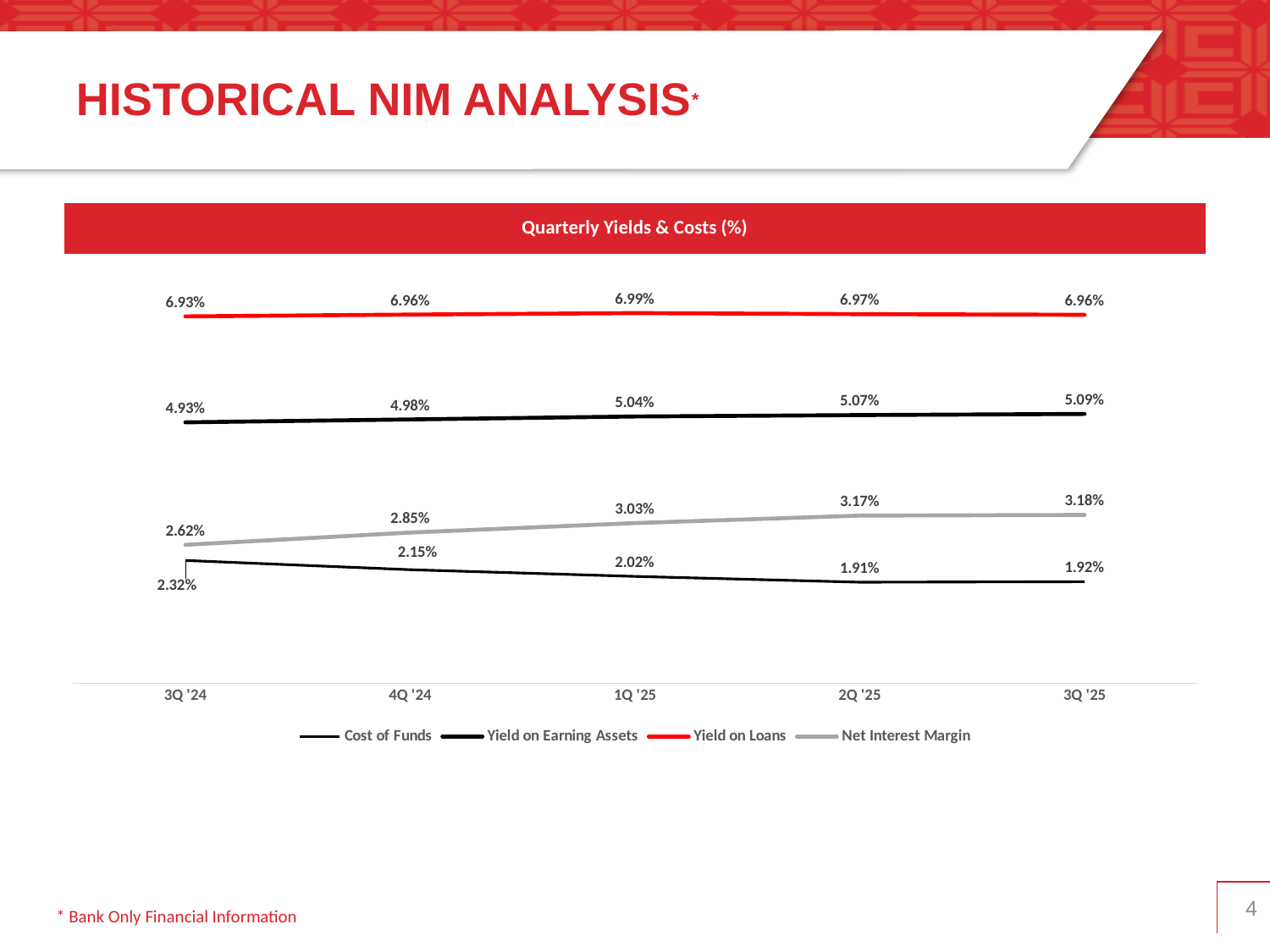
In which quarter is the Cost of Funds lowest? 2Q '25 What is the Net Interest Margin value for 3Q '24? 2.62% How many quarters are shown on the x axis? 5 What is the difference between the Net Interest Margin in 3Q '25 and in 3Q '24? 0.56% What is the Yield on Earning Assets value for 3Q '25? 5.09% What kind of chart is shown on the slide? Line chart Does the Yield on Earning Assets rise or fall from 3Q '24 to 3Q '25? Rise Which is larger in 4Q '24: the Net Interest Margin or the Cost of Funds? Net Interest Margin What is the Cost of Funds value for 2Q '25? 1.91% What is the Yield on Loans value for 1Q '25? 6.99% In which quarter is the Yield on Loans highest? 1Q '25 How many series does the legend list? 4